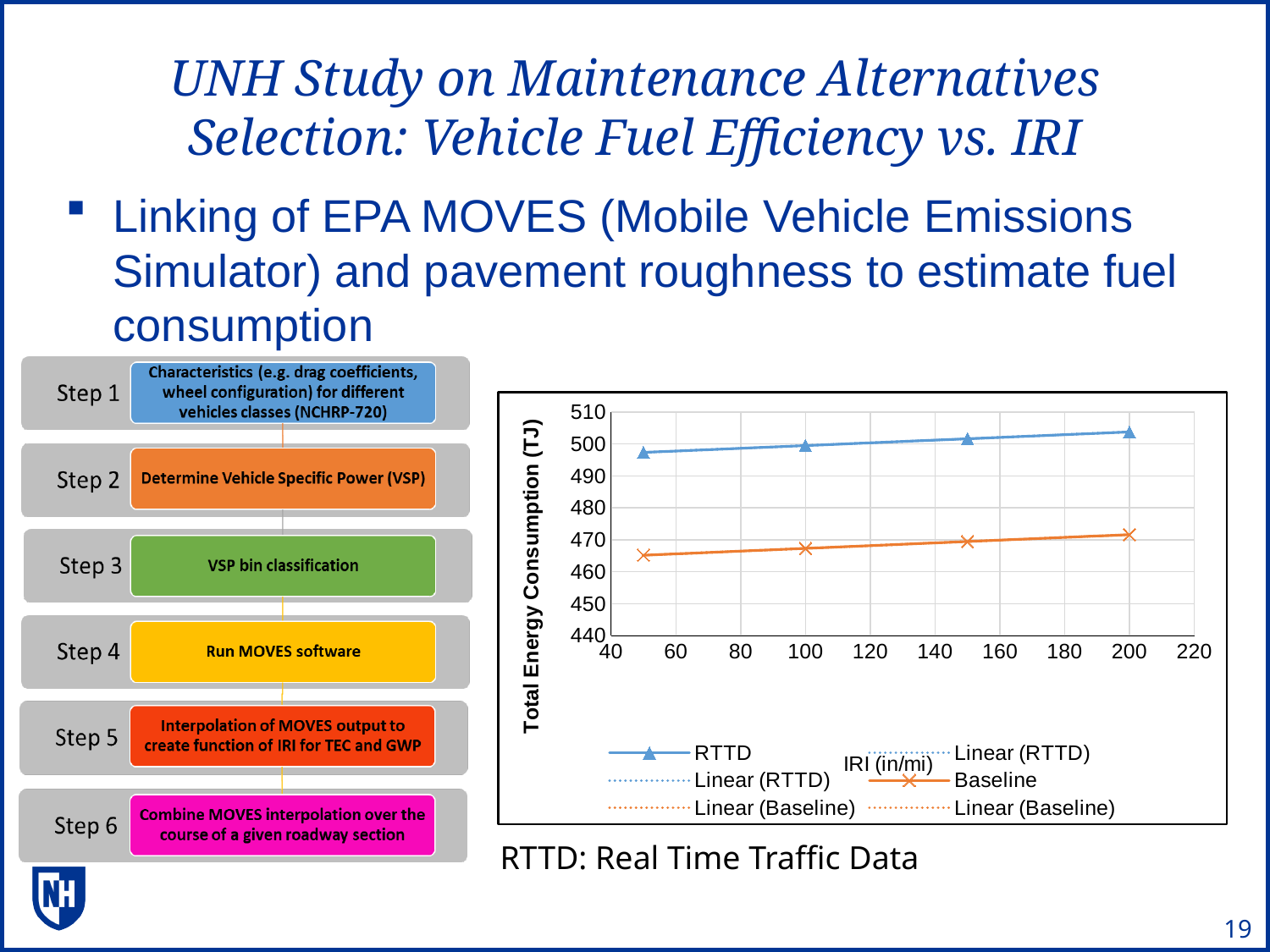
Does the Baseline series rise or fall as IRI increases along the x axis? rise Is the RTTD value at an IRI of 50 in/mi greater or less than 490? greater Which series has the higher Total Energy Consumption at an IRI of 100 in/mi, RTTD or Baseline? RTTD What is the label of the chart's y axis? Total Energy Consumption (TJ) What is the label of the chart's x axis? IRI (in/mi) Is the Baseline value at an IRI of 50 in/mi greater or less than 460? greater Is the RTTD value at an IRI of 200 in/mi greater or less than 510? less Does the RTTD series rise or fall as IRI increases along the x axis? rise What kind of chart is shown on the slide? line chart How many data points are plotted for the RTTD series? 4 How many entries does the chart legend list? 6